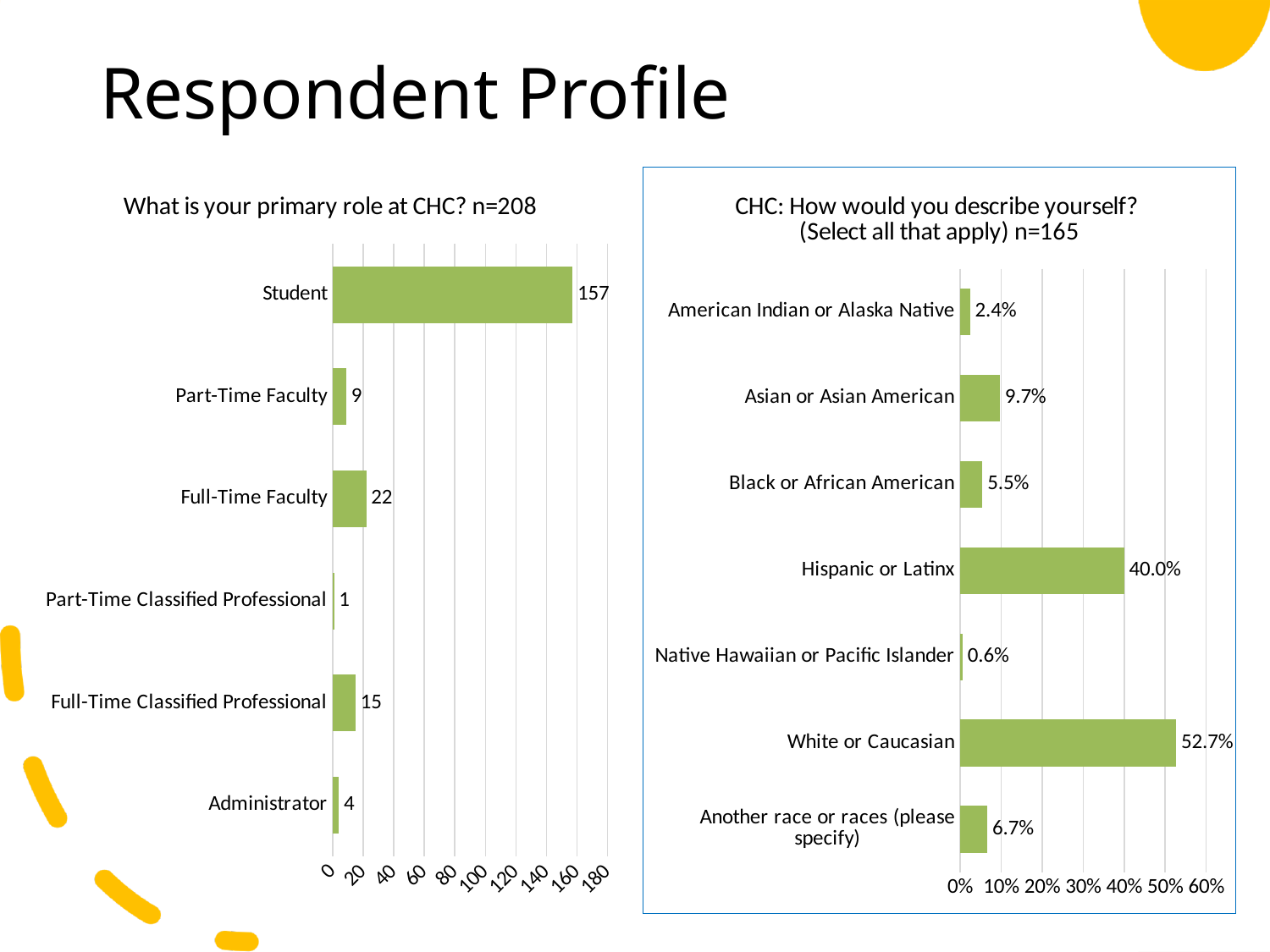
In the chart 'What is your primary role at CHC? n=208', what is the value for Student? 157 What kind of chart is the chart 'CHC: How would you describe yourself? (Select all that apply) n=165'? bar chart In the chart 'CHC: How would you describe yourself? (Select all that apply) n=165', which category has the highest value? White or Caucasian In the chart 'What is your primary role at CHC? n=208', what is the difference between Full-Time Faculty and Part-Time Faculty? 13 In the chart 'CHC: How would you describe yourself? (Select all that apply) n=165', which category has the lowest value? Native Hawaiian or Pacific Islander In the chart 'CHC: How would you describe yourself? (Select all that apply) n=165', what is the difference between White or Caucasian and Hispanic or Latinx? 12.7% In the chart 'CHC: How would you describe yourself? (Select all that apply) n=165', what is the value for Hispanic or Latinx? 40.0% In the chart 'What is your primary role at CHC? n=208', which category has the lowest value? Part-Time Classified Professional In the chart 'CHC: How would you describe yourself? (Select all that apply) n=165', which is larger: Asian or Asian American or Black or African American? Asian or Asian American In the chart 'What is your primary role at CHC? n=208', is the value for Student greater or less than 140? greater In the chart 'What is your primary role at CHC? n=208', what is the value for Full-Time Classified Professional? 15 In the chart 'What is your primary role at CHC? n=208', how many categories are shown? 6